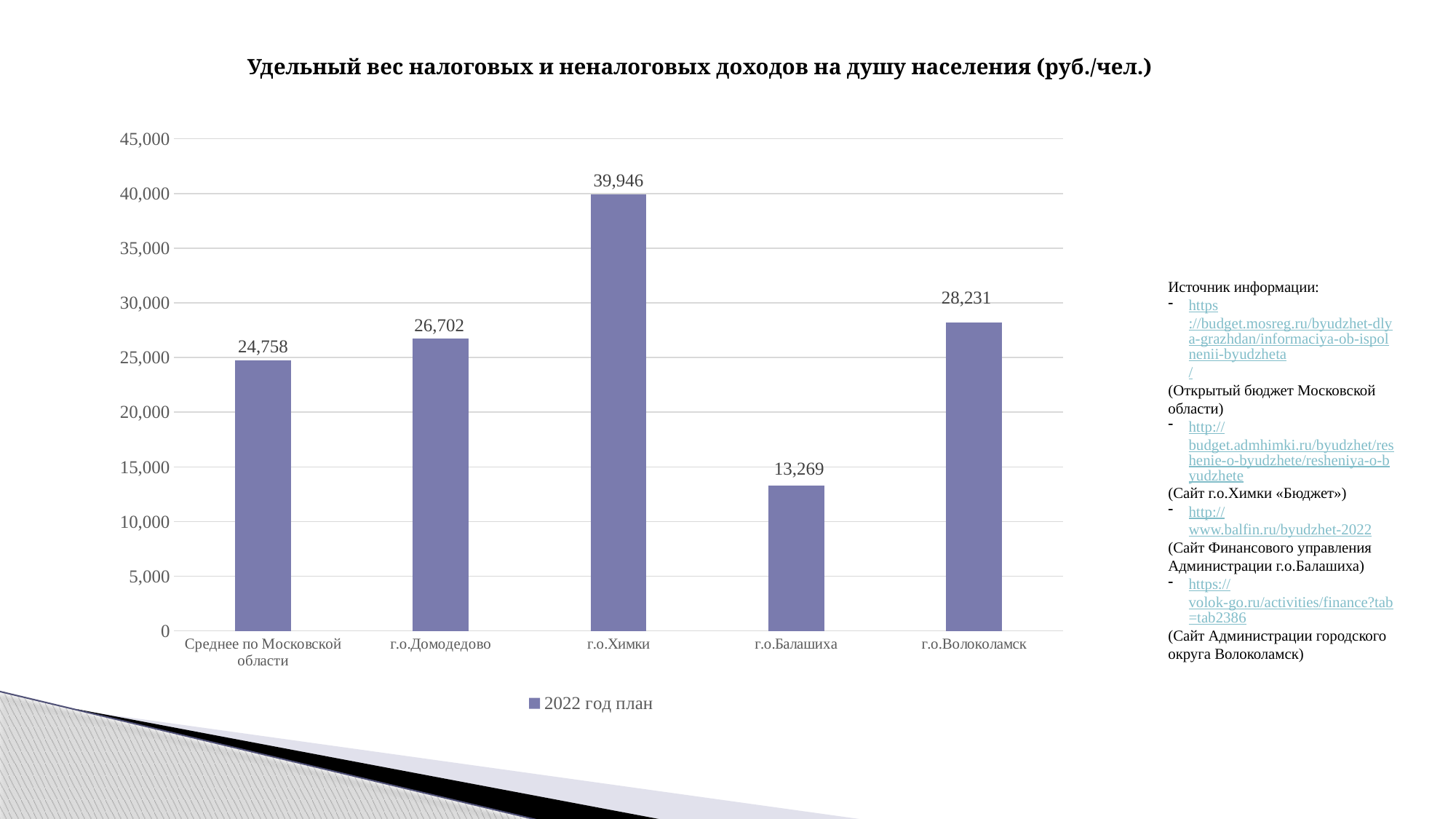
Is the value for г.о.Домодедово greater or less than 25,000? greater What is the value for Среднее по Московской области? 24,758 What is the difference between the values for г.о.Волоколамск and г.о.Домодедово? 1,529 What is the value for г.о.Балашиха? 13,269 How many categories are shown on the x axis? 5 What kind of chart is shown on the slide? bar chart What is the value for г.о.Химки? 39,946 Which category has the lowest value? г.о.Балашиха What is the difference between the values for г.о.Химки and г.о.Балашиха? 26,677 Which category has the highest value? г.о.Химки What series does the legend list? 2022 год план Which is larger, the value for г.о.Домодедово or the value for г.о.Волоколамск? г.о.Волоколамск